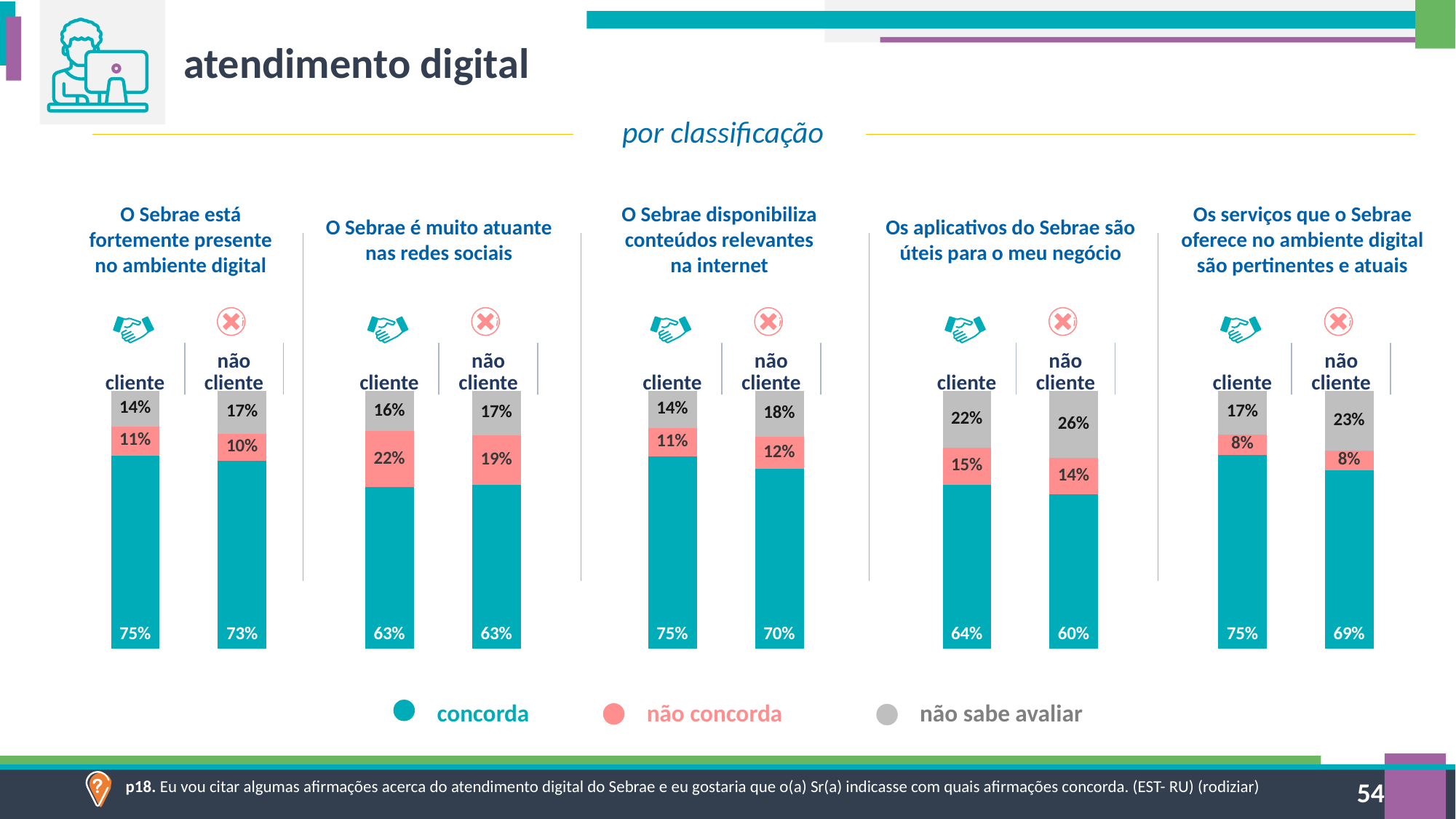
In the chart 'O Sebrae é muito atuante nas redes sociais', what is the total of the stacked bar for cliente? 101% In the chart 'Os aplicativos do Sebrae são úteis para o meu negócio', which group has the larger 'concorda' value, cliente or não cliente? cliente In the chart 'O Sebrae está fortemente presente no ambiente digital', what is the 'concorda' value for cliente? 75% What kind of chart is used for 'O Sebrae disponibiliza conteúdos relevantes na internet'? stacked bar chart In the chart 'O Sebrae disponibiliza conteúdos relevantes na internet', what is the difference between the 'concorda' values for cliente and não cliente? 5% How many series does the legend list? 3 Which legend entry is shown in pink? não concorda In the chart 'Os aplicativos do Sebrae são úteis para o meu negócio', what is the 'não sabe avaliar' value for não cliente? 26% In the chart 'Os serviços que o Sebrae oferece no ambiente digital são pertinentes e atuais', what is the 'concorda' value for não cliente? 69% How many bars are shown in the chart 'O Sebrae está fortemente presente no ambiente digital'? 2 In the chart 'Os serviços que o Sebrae oferece no ambiente digital são pertinentes e atuais', what is the total of the stacked bar for não cliente? 100% In the chart 'O Sebrae é muito atuante nas redes sociais', what is the 'não concorda' value for não cliente? 19%